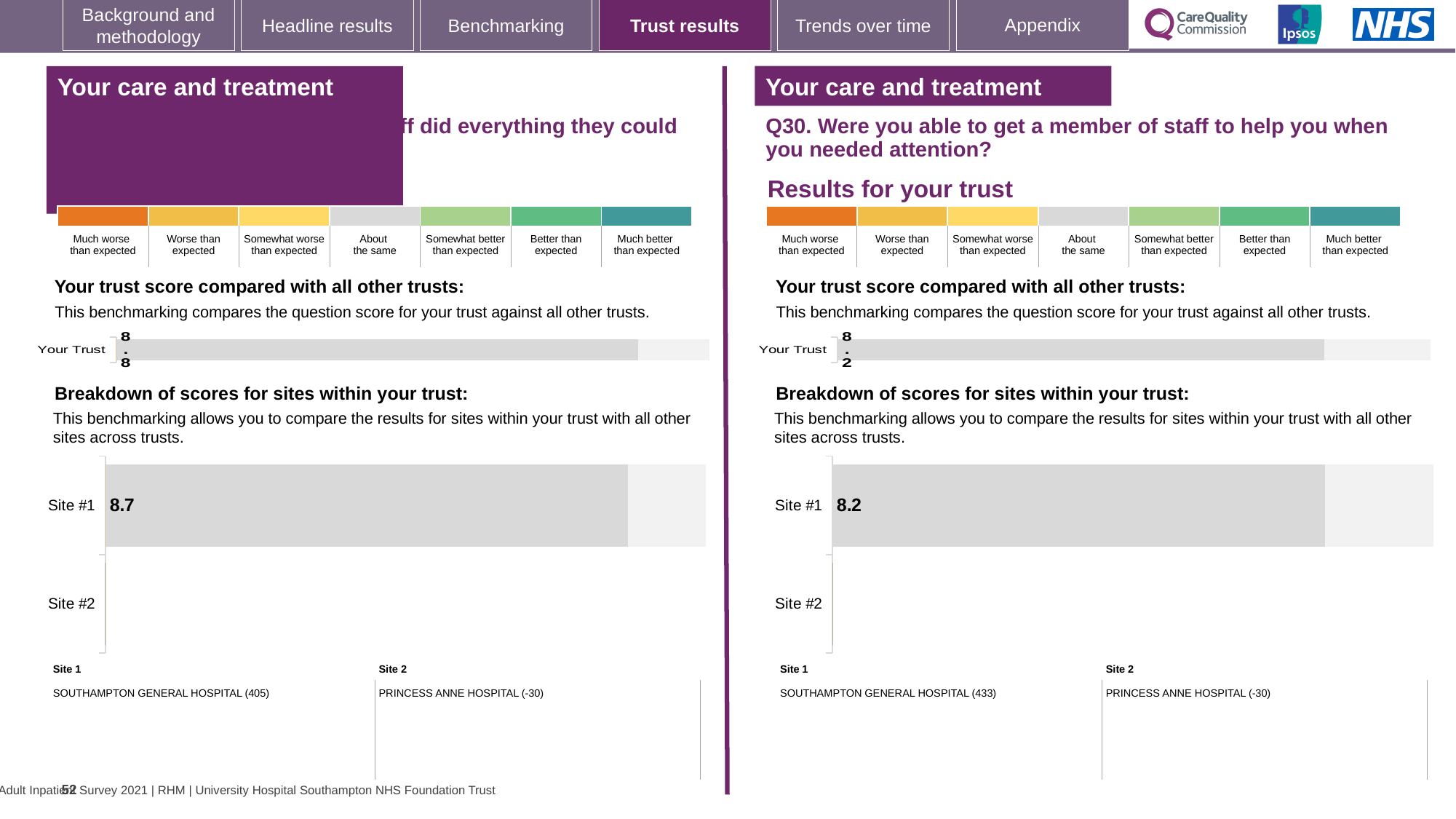
On the right panel (Q30), which hospital is listed as Site 1 below the breakdown chart? SOUTHAMPTON GENERAL HOSPITAL (433) On the left panel's 'Breakdown of scores for sites within your trust' chart, what is the value for Site #1? 8.7 What kind of chart is the 'Your trust score compared with all other trusts' chart on the left panel? Bar chart On the right panel (Q30) 'Your trust score compared with all other trusts' chart, what is the value shown for Your Trust? 8.2 On the left panel's 'Breakdown of scores for sites within your trust' chart, how many site categories are listed on the axis? 2 What is the difference between the Your Trust score on the left panel (8.8) and the Your Trust score on the right panel (8.2)? 0.6 On the right panel (Q30) 'Breakdown of scores for sites within your trust' chart, how many site categories are listed on the axis? 2 Which is larger: the Your Trust score on the left panel or the Your Trust score on the right panel (Q30)? Left panel (8.8) On the right panel (Q30) 'Breakdown of scores for sites within your trust' chart, what is the value for Site #1? 8.2 On the left panel's 'Your trust score compared with all other trusts' chart, what is the value shown for Your Trust? 8.8 On the left panel's 'Breakdown of scores for sites within your trust' chart, which site has a bar plotted? Site #1 What kind of chart is the 'Breakdown of scores for sites within your trust' chart on the right panel (Q30)? Bar chart